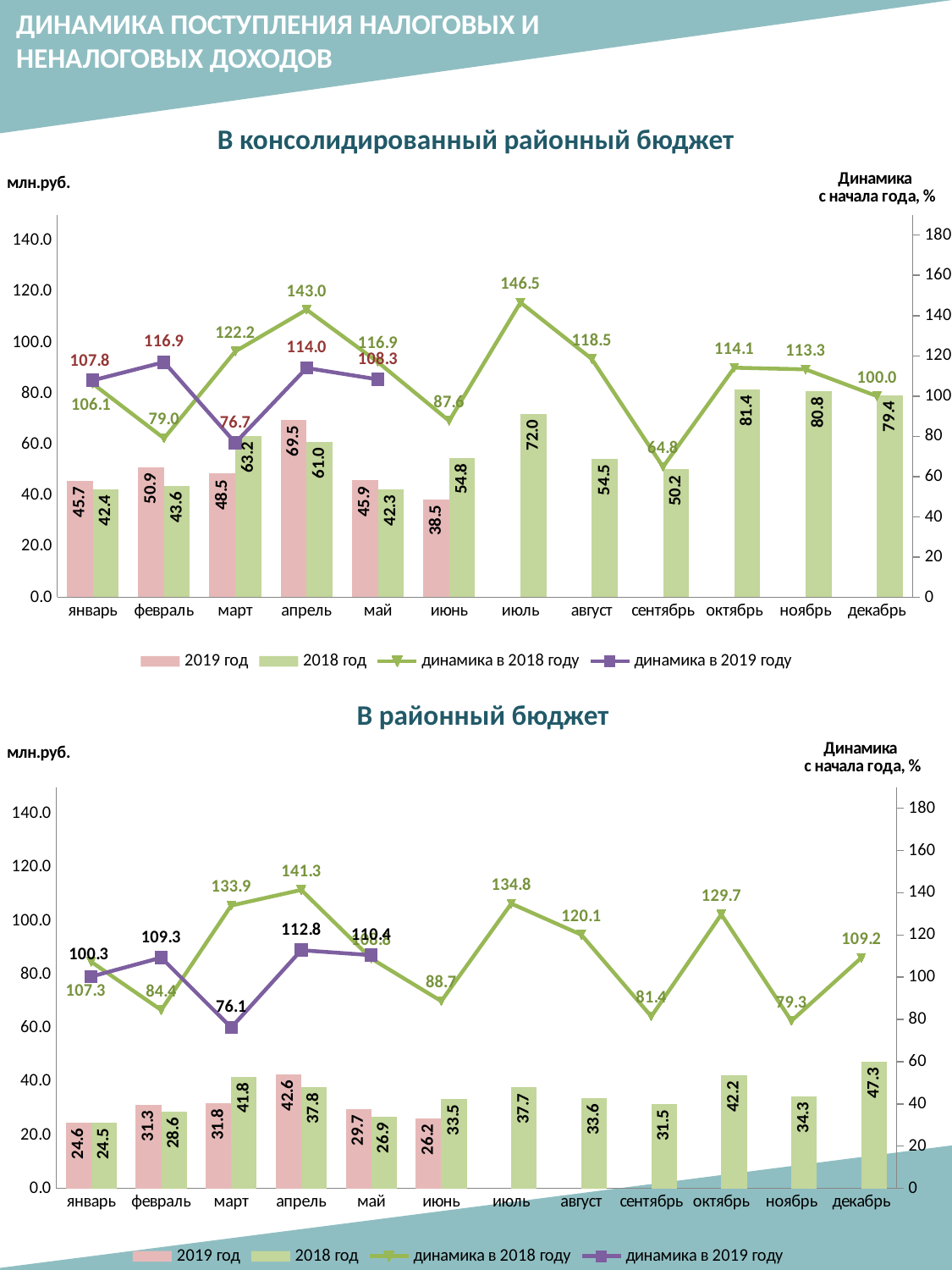
In the chart 'В консолидированный районный бюджет', what is the value of the '2018 год' bar for октябрь? 81.4 In the chart 'В консолидированный районный бюджет', which month has the highest value on the 'динамика в 2018 году' line? июль In the chart 'В районный бюджет', what is the value of the '2018 год' bar for декабрь? 47.3 In the chart 'В консолидированный районный бюджет', what is the value of the '2019 год' bar for апрель? 69.5 In the chart 'В районный бюджет', which is larger for февраль: the '2019 год' bar or the '2018 год' bar? 2019 год In the chart 'В консолидированный районный бюджет', how many series does the legend list? 4 In the chart 'В районный бюджет', what is the value of the 'динамика в 2019 году' line for март? 76.1 In the chart 'В консолидированный районный бюджет', which month has the lowest value on the 'динамика в 2018 году' line? сентябрь In the chart 'В консолидированный районный бюджет', what is the difference between the '2019 год' and '2018 год' bars for март? 14.7 In the chart 'В районный бюджет', how many months are shown on the x axis? 12 In the chart 'В районный бюджет', which month has the highest value on the 'динамика в 2018 году' line? апрель What kind of chart is 'В районный бюджет'? Combined bar and line chart